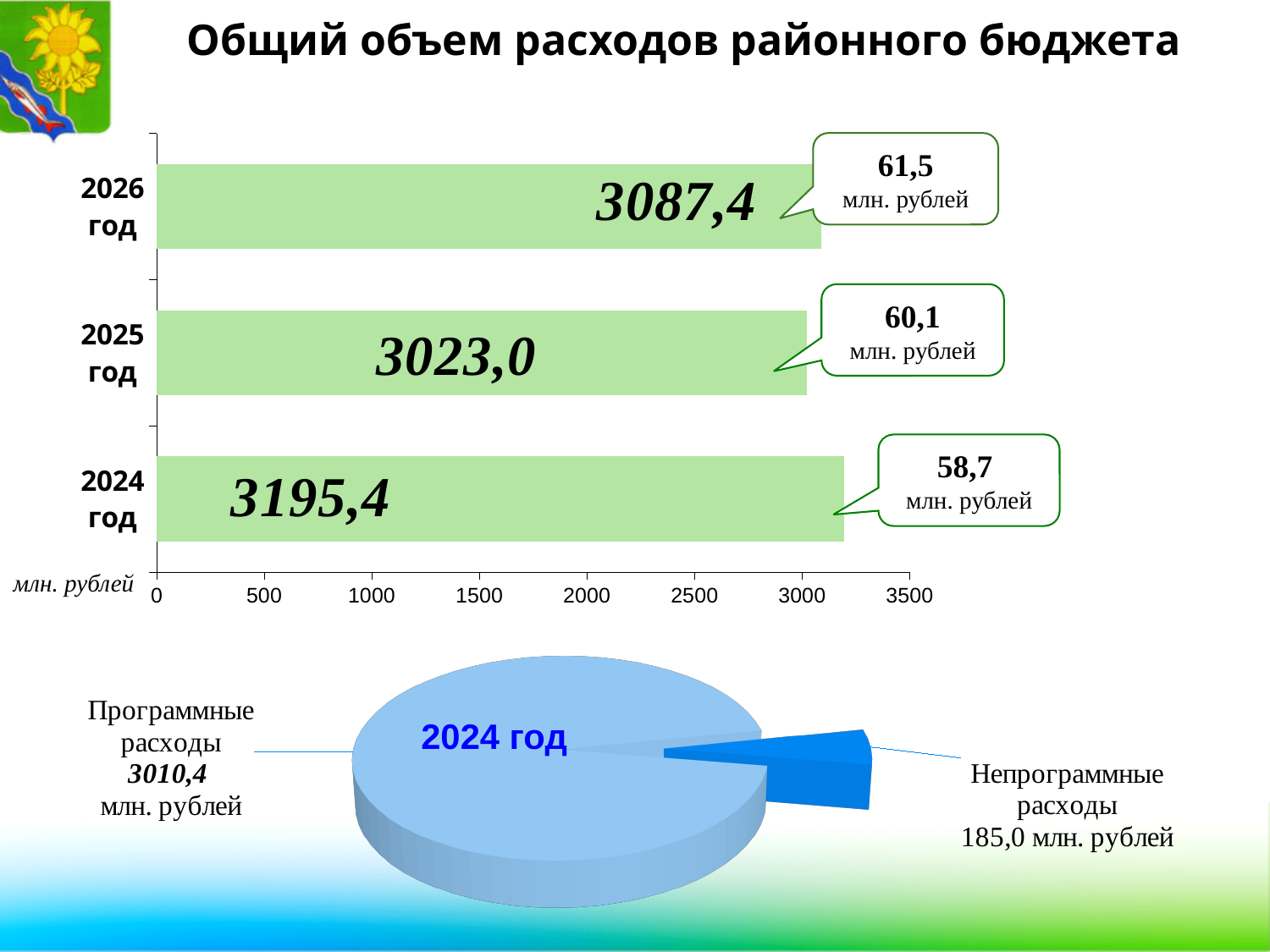
In the bar chart, what is the difference between the values for 2024 год and 2025 год? 172,4 In the bar chart, which year has the highest value? 2024 год In the pie chart, what is the value for Программные расходы? 3010,4 млн. рублей In the bar chart, what is the value for 2026 год? 3087,4 In the bar chart, what is the value for 2024 год? 3195,4 In the bar chart, what value is shown in the callout next to the 2024 год bar? 58,7 млн. рублей In the bar chart, which year has the lowest value? 2025 год In the bar chart, what is the value for 2025 год? 3023,0 What kind of chart is the upper chart on the slide? bar chart In the bar chart, which is larger: the value for 2026 год or the value for 2025 год? 2026 год In the bar chart, how many years are shown? 3 In the pie chart, what is the value for Непрограммные расходы? 185,0 млн. рублей